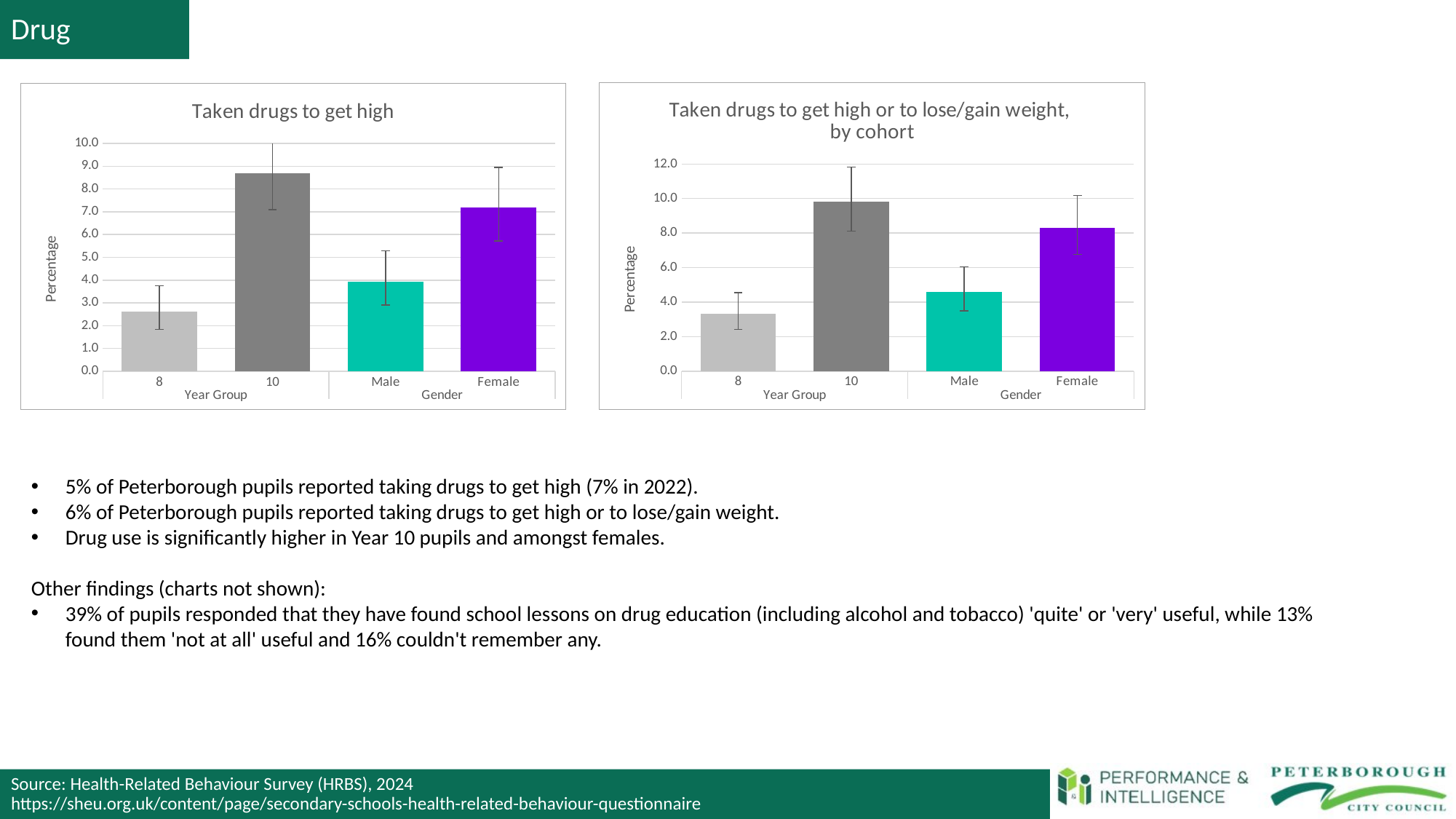
In the chart titled 'Taken drugs to get high or to lose/gain weight, by cohort', which category has the highest value? 10 In the chart titled 'Taken drugs to get high or to lose/gain weight, by cohort', which category has the lowest value? 8 What kind of chart is the chart titled 'Taken drugs to get high'? Bar chart In the chart titled 'Taken drugs to get high', is the value for Year Group 10 greater or less than 8.0? greater In the chart titled 'Taken drugs to get high', which is larger, the value for Male or the value for Female? Female In the chart titled 'Taken drugs to get high', is the value for Year Group 8 greater or less than 3.0? less In the chart titled 'Taken drugs to get high or to lose/gain weight, by cohort', is the value for Year Group 10 greater or less than 8.0? greater In the chart titled 'Taken drugs to get high', which category has the highest value? 10 How many bars are plotted in the chart titled 'Taken drugs to get high or to lose/gain weight, by cohort'? 4 In the chart titled 'Taken drugs to get high', which category has the lowest value? 8